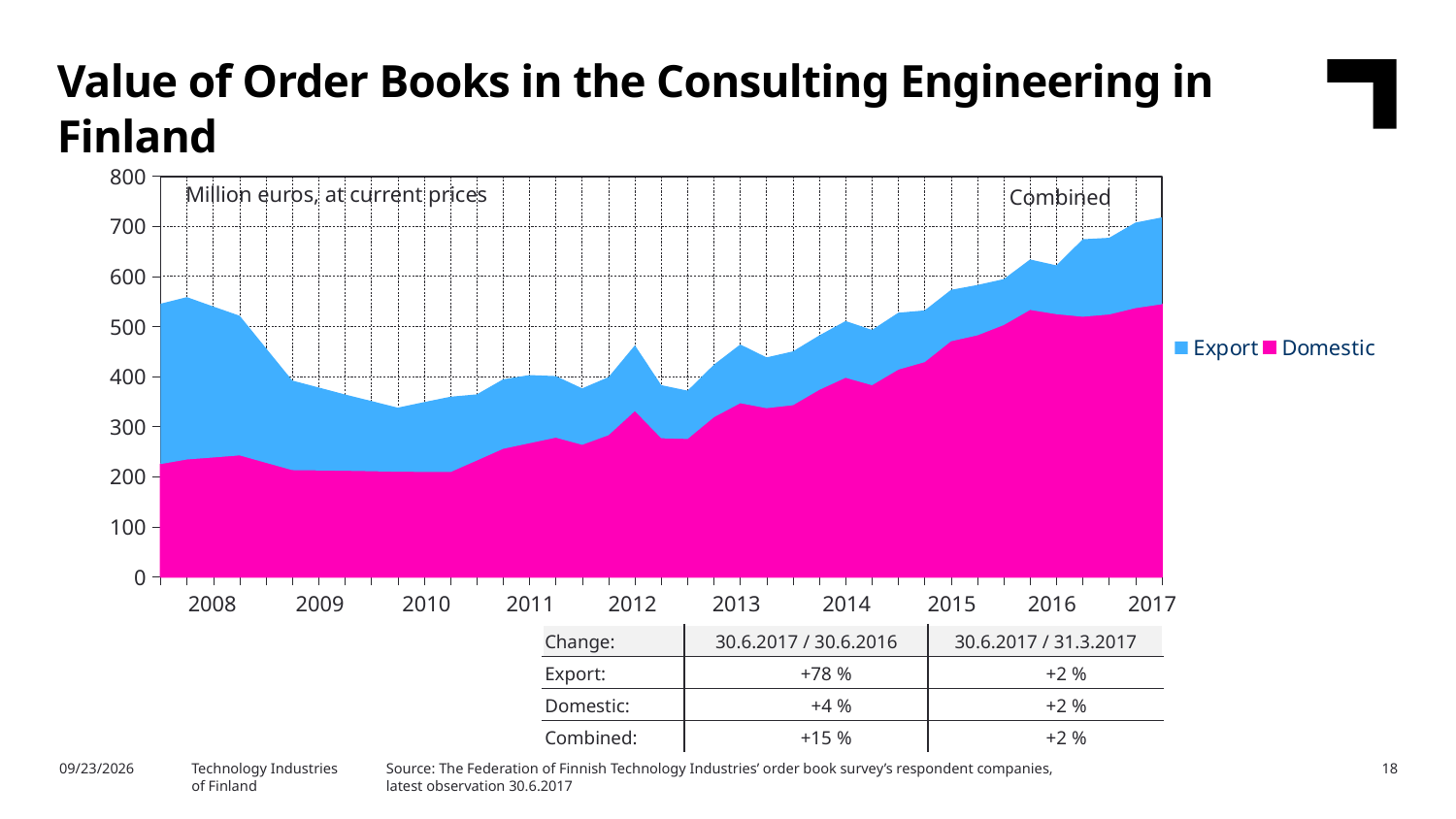
Does the combined value of order books rise or fall between 2008 and 2010? fall In which year does the combined value of order books reach its highest level on the chart? 2017 In what unit are the values on the chart expressed, according to the note inside the plot area? Million euros, at current prices What kind of chart is shown on the slide? Stacked area chart Is the combined value of order books at the end of 2017 greater or less than 700? greater Is the combined value of order books in 2010 greater or less than 400? less Is the combined value of order books at the start of 2008 greater or less than 500? greater What are the two series named in the chart legend? Export and Domestic Does the combined value of order books rise or fall between 2010 and 2017? rise How many series does the chart legend list? 2